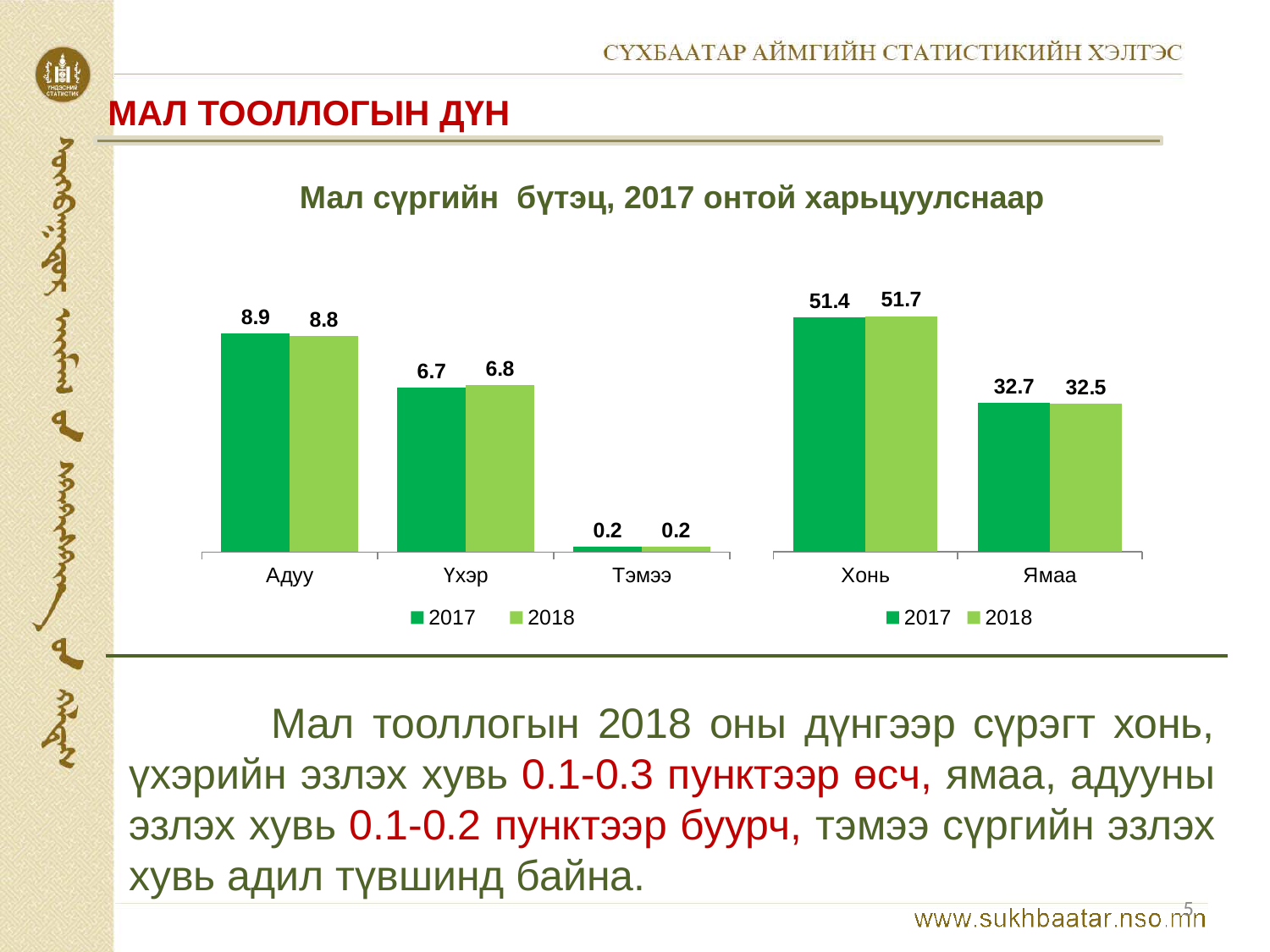
In the right chart, what is the 2017 value for Ямаа? 32.7 In the left chart, what is the 2017 value for Адуу? 8.9 In the left chart, which category has the lowest values? Тэмээ How many series does the legend of the right chart list? 2 In the right chart, what is the difference between the 2017 and 2018 values for Хонь? 0.3 In the right chart, which is larger: the 2017 value for Ямаа or the 2018 value for Ямаа? 2017 What type of chart is the right chart? Bar chart How many categories are shown in the left chart? 3 In the left chart, what is the difference between the 2017 and 2018 values for Адуу? 0.1 In the right chart, what is the 2018 value for Хонь? 51.7 In the left chart, what is the 2018 value for Үхэр? 6.8 In the left chart, which category has the highest 2018 value? Адуу